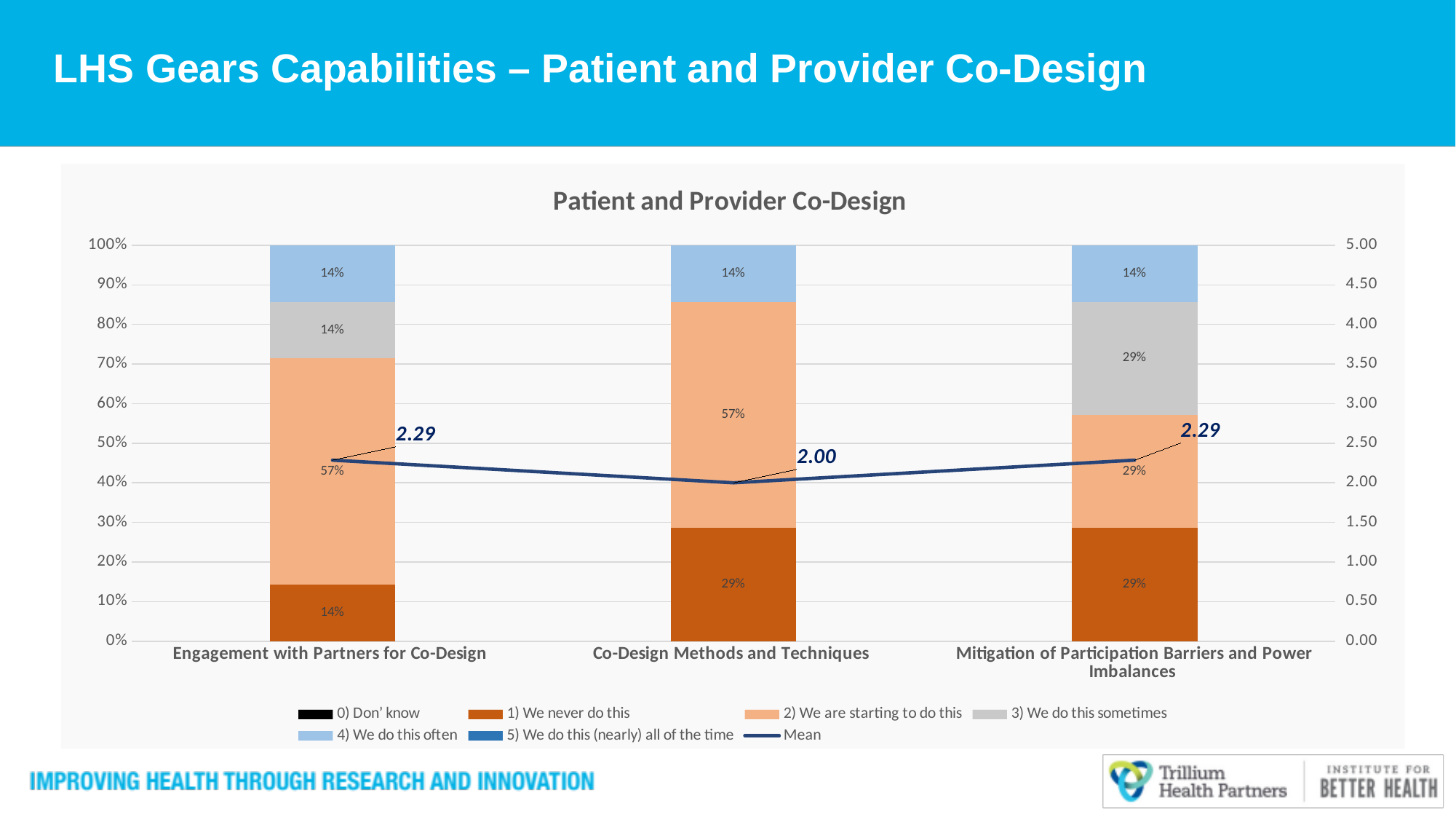
What percentage of respondents chose '2) We are starting to do this' for Engagement with Partners for Co-Design? 57% What is the Mean value for Co-Design Methods and Techniques? 2.00 Which category has the lowest Mean value? Co-Design Methods and Techniques What percentage of respondents chose '1) We never do this' for Mitigation of Participation Barriers and Power Imbalances? 29% How many categories are shown on the x axis of the chart? 3 What is the difference in the '2) We are starting to do this' share between Co-Design Methods and Techniques and Mitigation of Participation Barriers and Power Imbalances? 28 percentage points What is the title of the chart? Patient and Provider Co-Design How many series does the chart's legend list? 7 What kind of chart is shown on the slide? combination bar and line chart (stacked bars with a mean line) What percentage of respondents chose '4) We do this often' for Co-Design Methods and Techniques? 14% What percentage of respondents chose '3) We do this sometimes' for Mitigation of Participation Barriers and Power Imbalances? 29% Which category has the larger share for '1) We never do this': Engagement with Partners for Co-Design or Co-Design Methods and Techniques? Co-Design Methods and Techniques